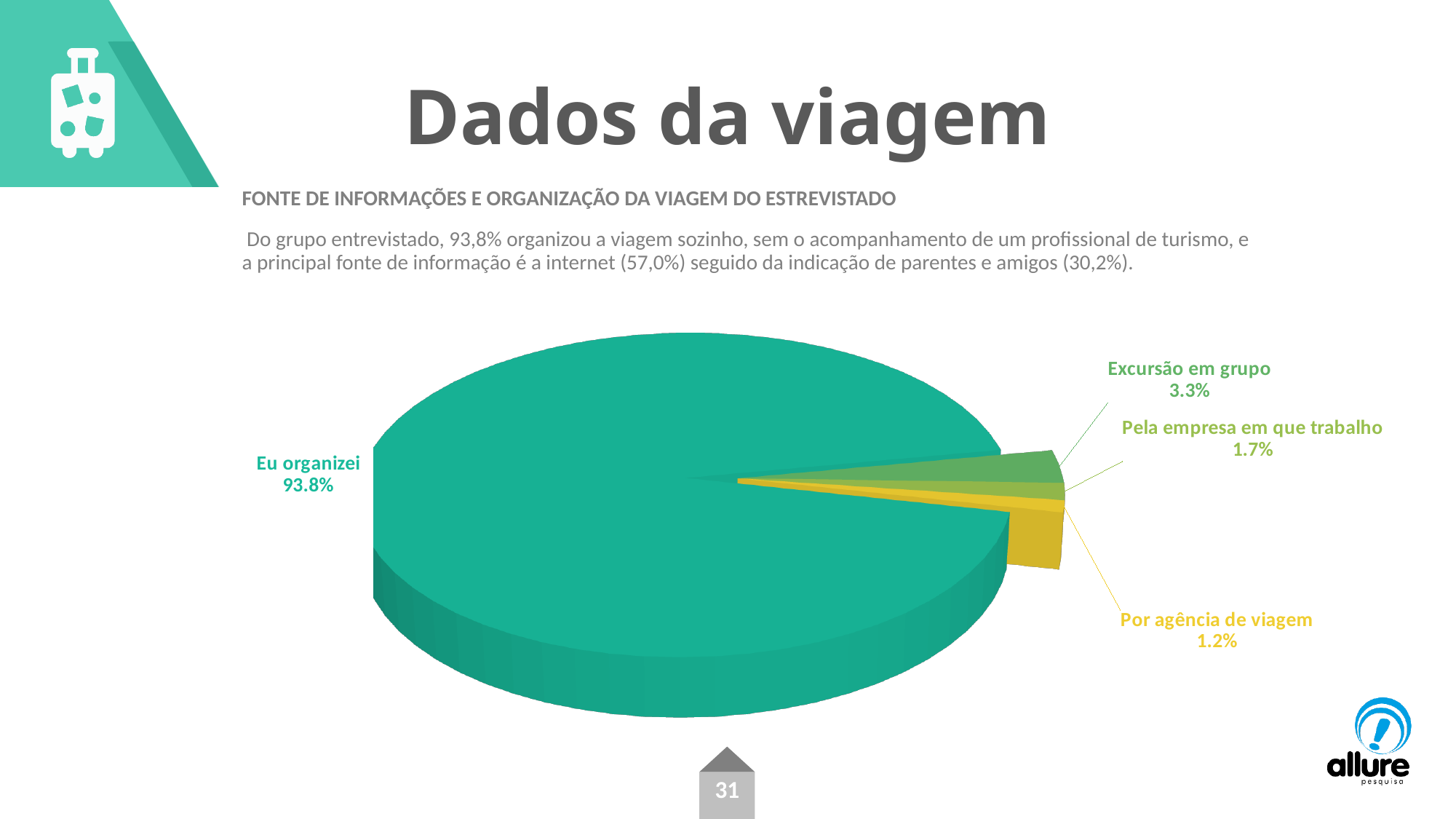
What is the value for "Excursão em grupo"? 3.3% What is the difference between "Excursão em grupo" and "Por agência de viagem"? 2.1% What colour is the "Eu organizei" slice? Teal green Which category has the smallest slice of the pie? Por agência de viagem What is the difference between "Eu organizei" and "Excursão em grupo"? 90.5% How many categories are shown in the pie chart? 4 What kind of chart is shown on the slide? Pie chart What is the value for "Por agência de viagem"? 1.2% Which category has the largest slice of the pie? Eu organizei Which is larger, "Pela empresa em que trabalho" or "Por agência de viagem"? Pela empresa em que trabalho What is the value for "Pela empresa em que trabalho"? 1.7% What share of the pie does "Eu organizei" represent? 93.8%